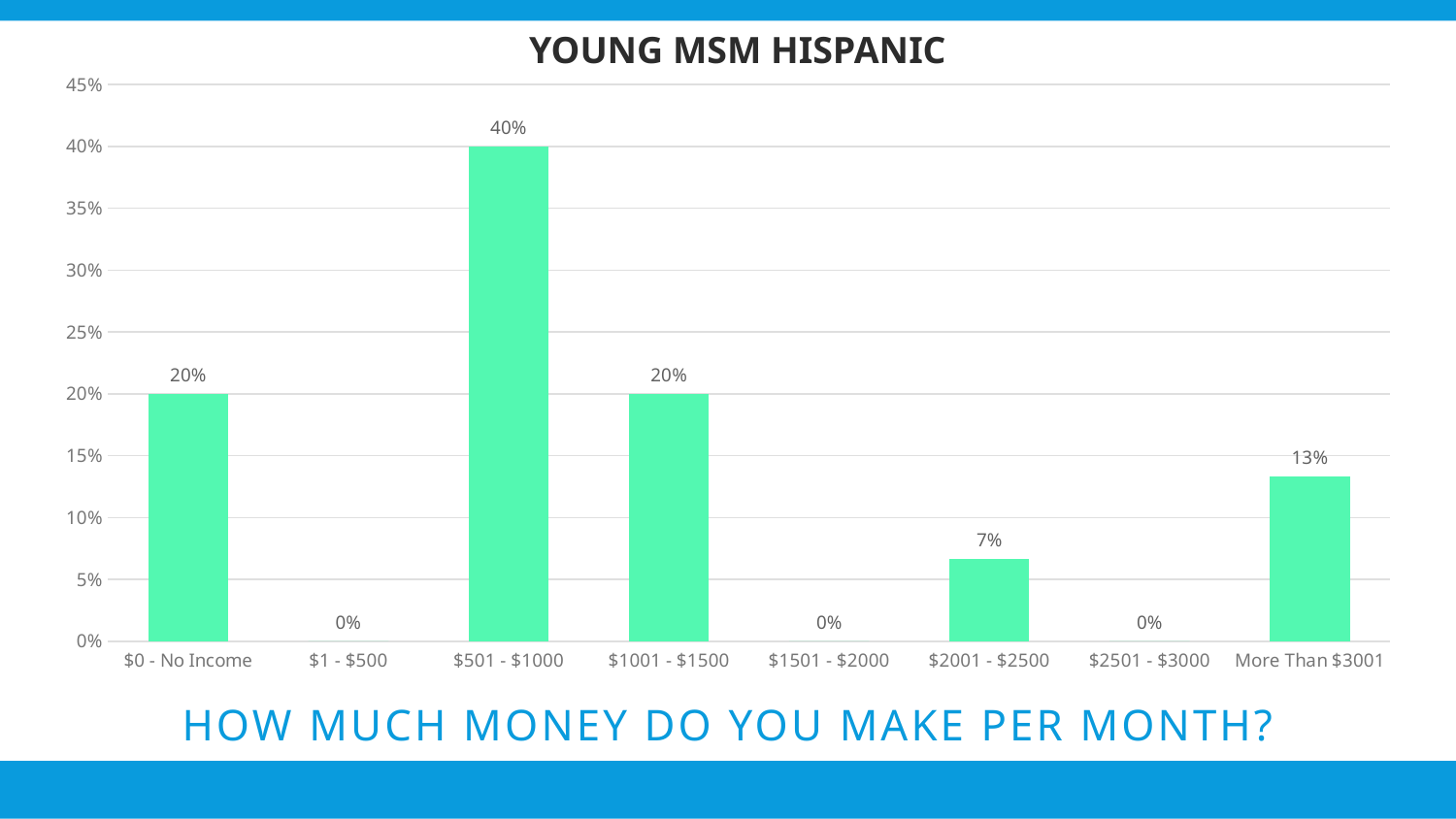
What is the value for the More Than $3001 category? 13% What is the difference between the More Than $3001 value and the $2001 - $2500 value? 6% What is the value for the $501 - $1000 category? 40% Is the value for $501 - $1000 greater or less than 35%? greater Which category has the highest value? $501 - $1000 Which is larger, the value for $2001 - $2500 or the value for More Than $3001? More Than $3001 What is the value for the $2001 - $2500 category? 7% What is the title of the chart? YOUNG MSM HISPANIC How many categories are shown on the x axis? 8 What is the value for the $0 - No Income category? 20% What kind of chart is shown on the slide? bar chart What is the difference between the $501 - $1000 value and the $1001 - $1500 value? 20%